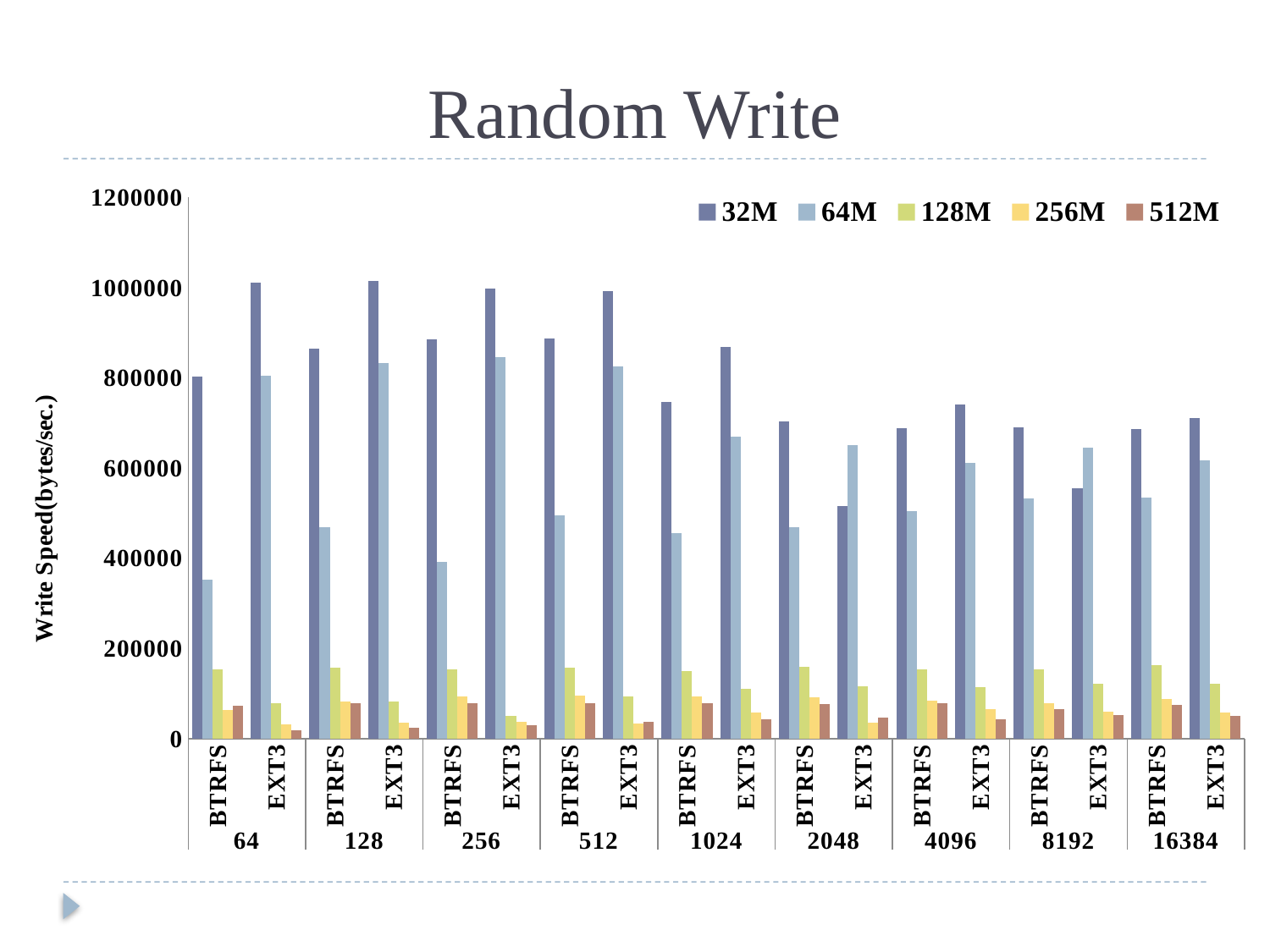
What kind of chart is shown on the slide? bar chart What is the title of the chart? Random Write How many block-size groups are shown along the x axis? 9 Is the 32M value for EXT3 in the 2048 group greater or less than 600000? less What is the label of the y axis? Write Speed(bytes/sec.) How many series does the legend list? 5 In the 8192 group, which has the larger 32M value, BTRFS or EXT3? BTRFS Is the 64M value for BTRFS in the 64 group greater or less than 400000? less Which series has the lowest values across the chart? 512M Is the 64M value for EXT3 in the 2048 group greater or less than 600000? greater In the 64 group, which has the larger 32M value, BTRFS or EXT3? EXT3